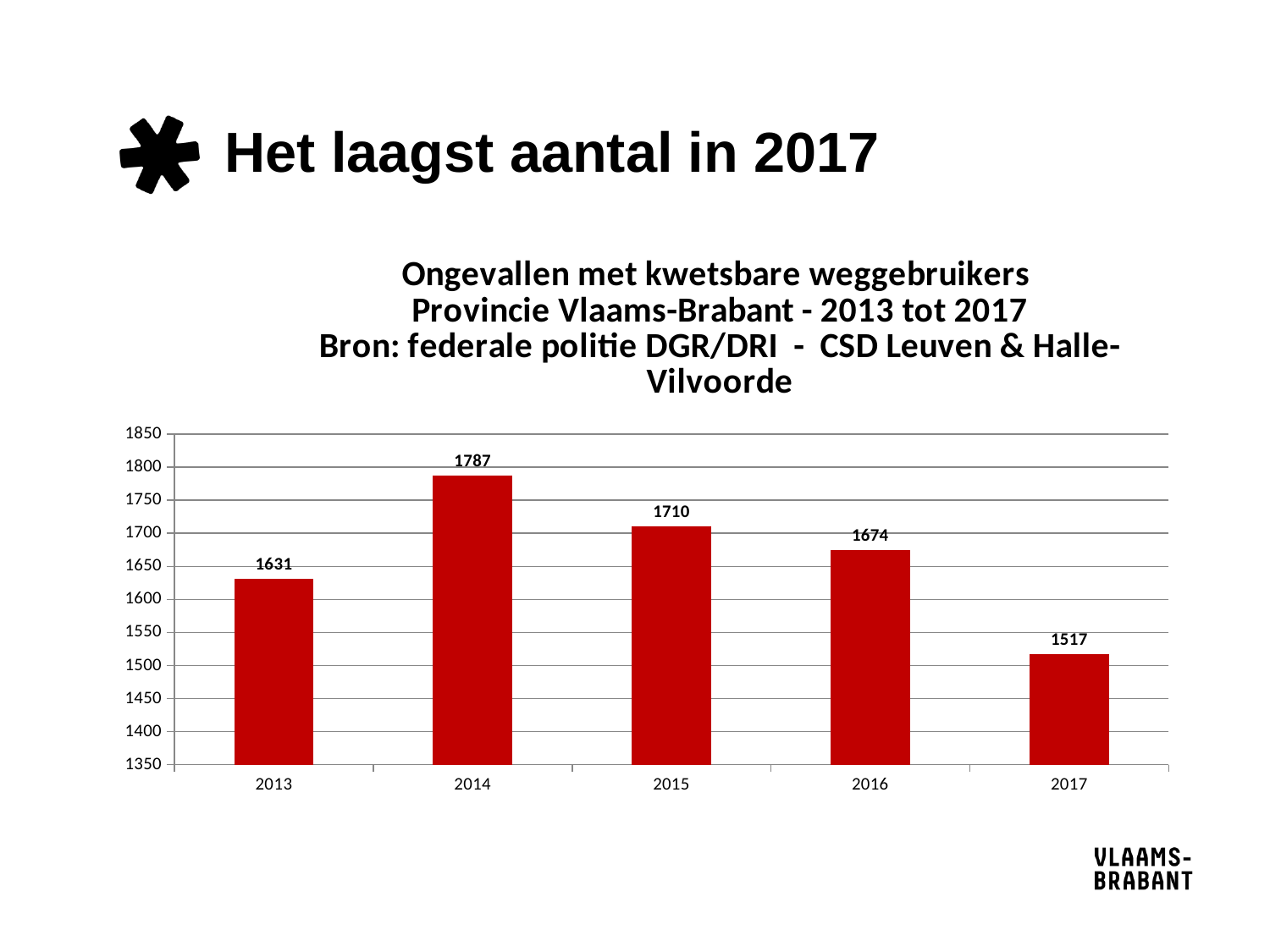
What is the value for 2014? 1787 Which year has the lowest value? 2017 Which year has the highest value? 2014 What is the value for 2017? 1517 Do the values rise or fall from 2014 to 2017? fall What is the difference between the values for 2014 and 2017? 270 How many years are shown on the x axis? 5 Is the value for 2015 greater or less than 1700? greater What is the difference between the values for 2015 and 2016? 36 What is the value for 2013? 1631 Which is larger, the value for 2013 or the value for 2016? 2016 What kind of chart is shown on the slide? bar chart